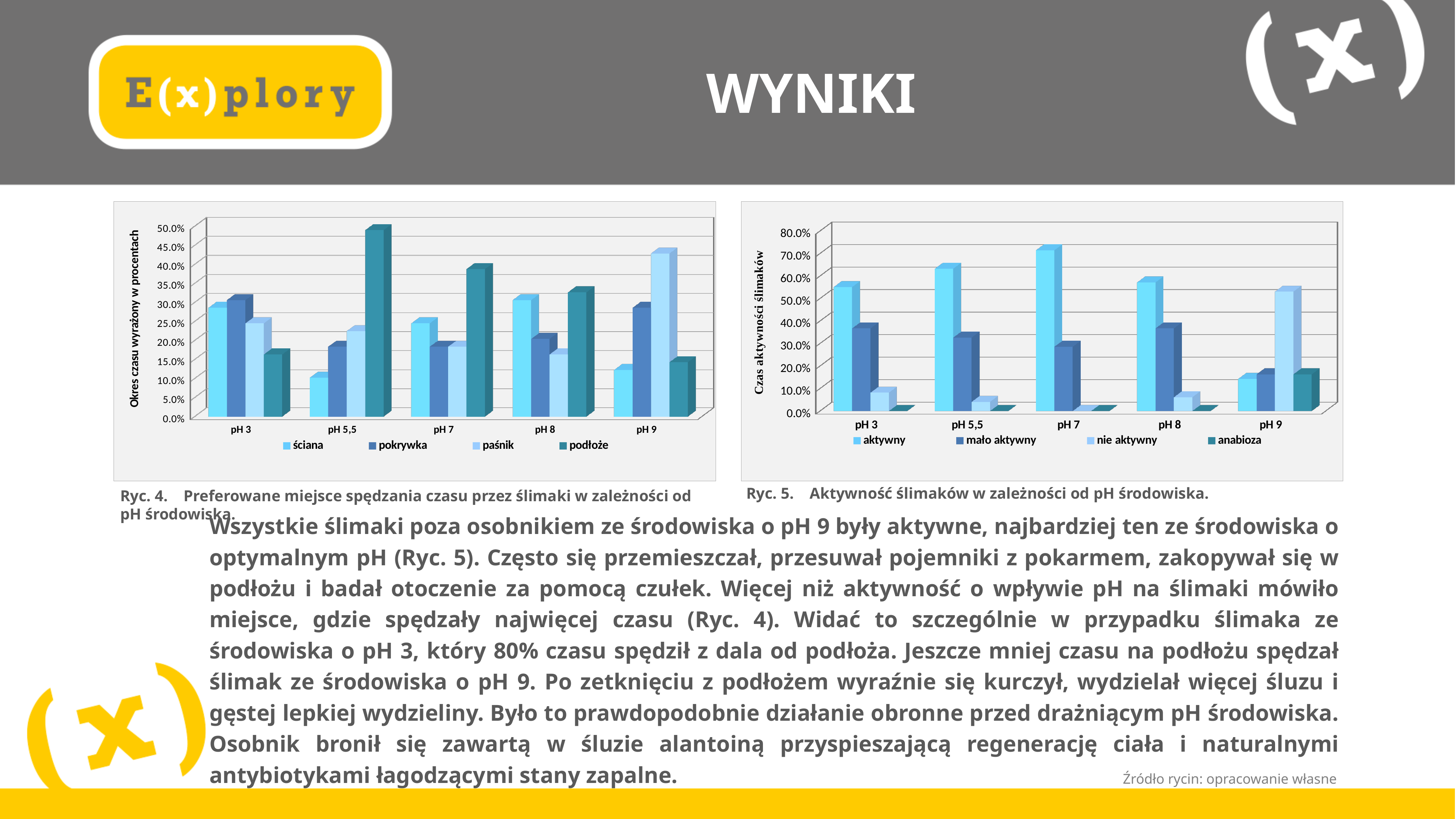
In the right chart (Ryc. 5), is the value for aktywny at pH 7 greater or less than 60%? greater In the left chart (Ryc. 4), how many pH categories are shown on the x axis? 5 In the left chart (Ryc. 4), at which pH category is the podłoże bar the highest? pH 5,5 In the left chart (Ryc. 4), is the value for ściana at pH 9 greater or less than 15%? less In the left chart (Ryc. 4), is the value for podłoże at pH 5,5 greater or less than 45%? greater In the left chart (Ryc. 4), how many series does the legend list? 4 In the left chart (Ryc. 4), which is larger at pH 9: paśnik or pokrywka? paśnik In the right chart (Ryc. 5), what are the four series listed in the legend? aktywny, mało aktywny, nie aktywny, anabioza What kind of chart is the right chart (Ryc. 5)? bar chart In the right chart (Ryc. 5), at which pH category is the aktywny bar the highest? pH 7 In the right chart (Ryc. 5), which is larger at pH 3: aktywny or mało aktywny? aktywny